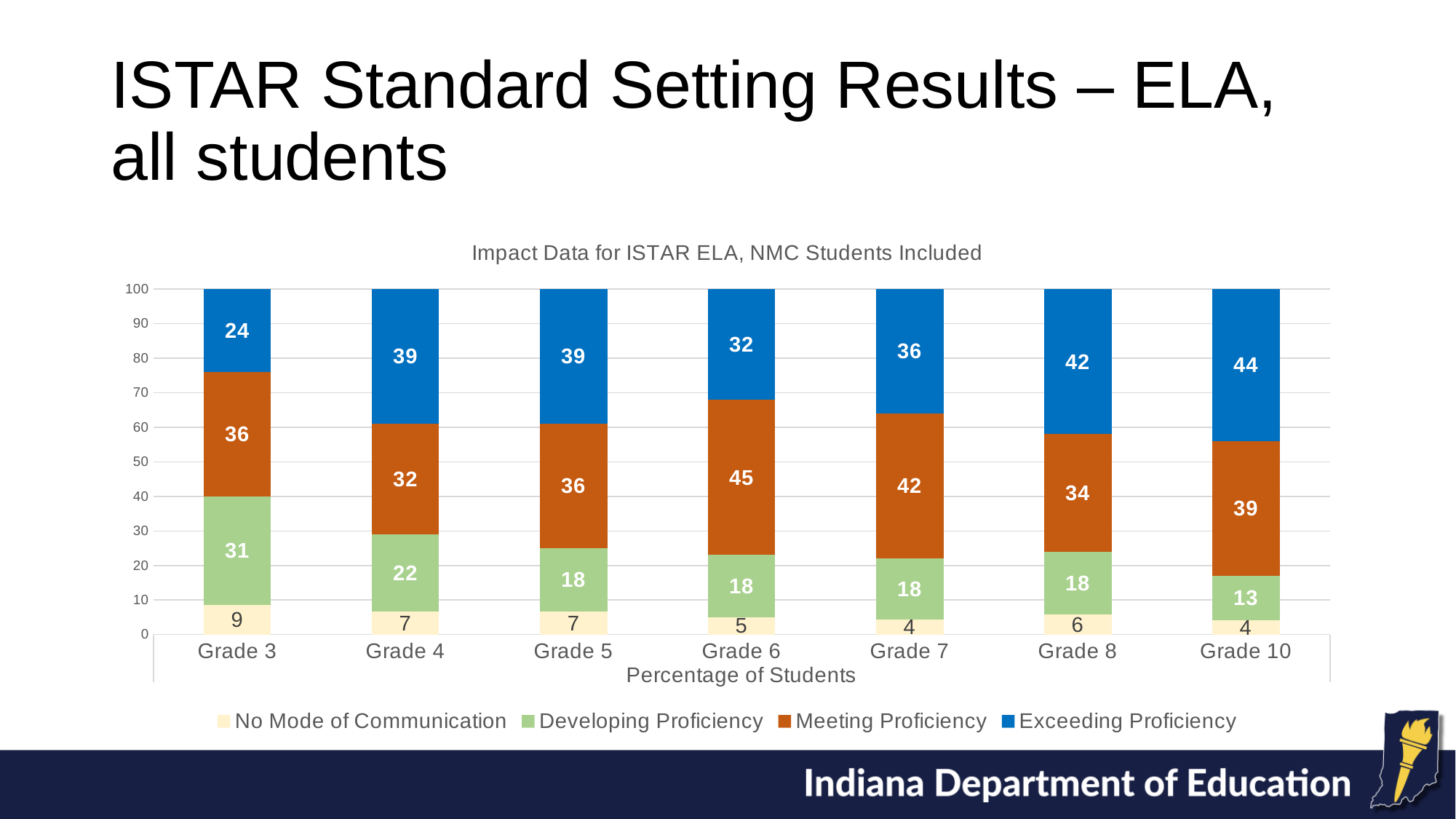
What is the total of the stacked bar for Grade 5? 100 What is the title of the chart? Impact Data for ISTAR ELA, NMC Students Included Which grade has the highest No Mode of Communication value? Grade 3 How many grades are shown on the x axis? 7 How many series does the legend list? 4 Which grade has the lowest Developing Proficiency value? Grade 10 What is the Exceeding Proficiency value for Grade 3? 24 What kind of chart is shown on the slide? Stacked bar chart Which grade has the highest Exceeding Proficiency value? Grade 10 What is the Meeting Proficiency value for Grade 6? 45 Which has the larger Meeting Proficiency value, Grade 7 or Grade 8? Grade 7 What is the difference between the Developing Proficiency values for Grade 3 and Grade 10? 18